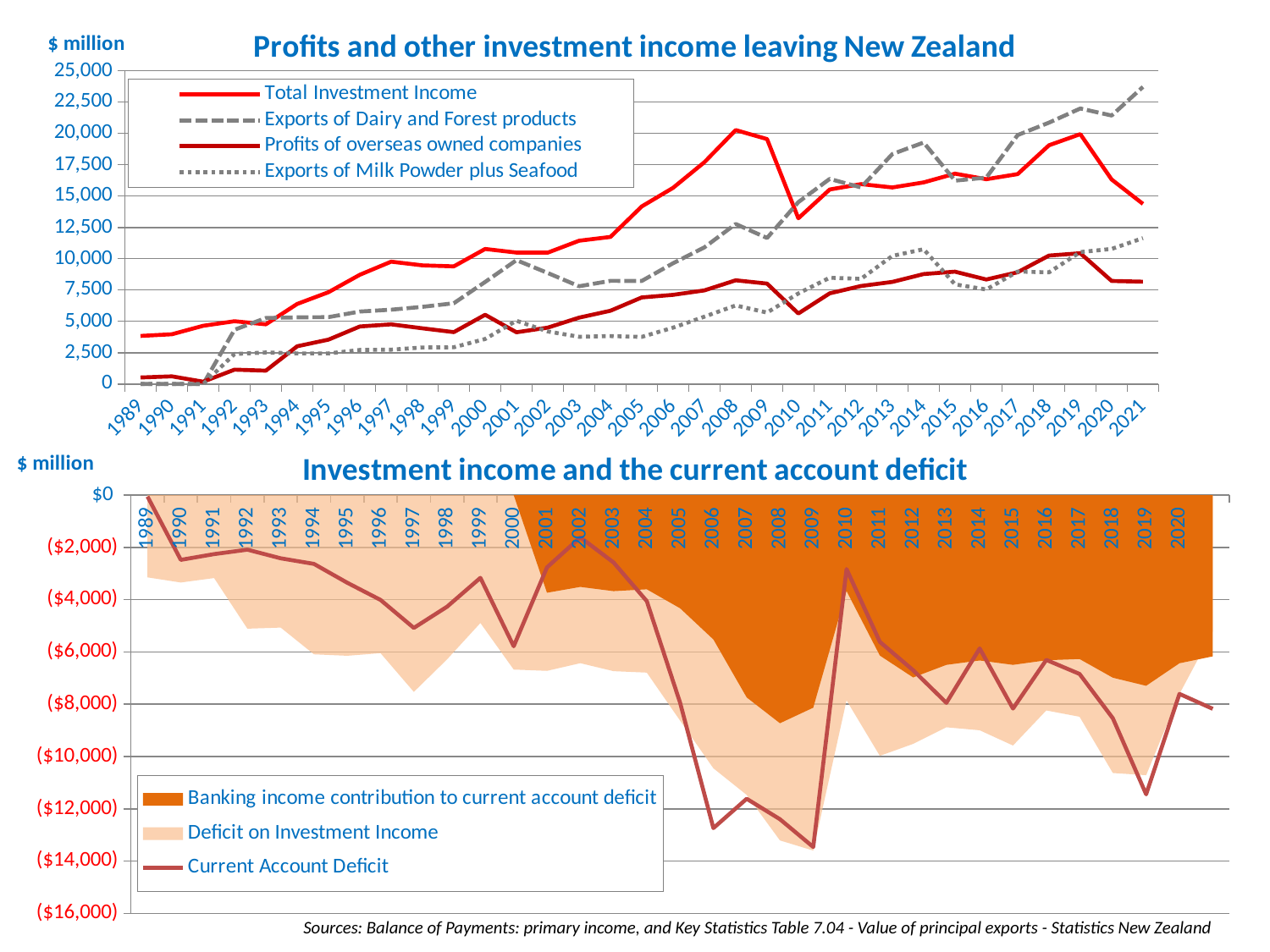
In the top chart, 'Profits and other investment income leaving New Zealand', is the value for Profits of overseas owned companies in 2021 greater or less than 10,000? less In the top chart, 'Profits and other investment income leaving New Zealand', how many years are shown on the x axis? 33 In the top chart, 'Profits and other investment income leaving New Zealand', is the value for Total Investment Income in 2010 greater or less than 15,000? less In the bottom chart, 'Investment income and the current account deficit', is the value for Current Account Deficit in 2009 greater or less than ($12,000)? less In the top chart, 'Profits and other investment income leaving New Zealand', which is larger in 2021: Total Investment Income or Exports of Dairy and Forest products? Exports of Dairy and Forest products In the bottom chart, 'Investment income and the current account deficit', in which year is the Current Account Deficit line at its lowest point? 2009 In the top chart, 'Profits and other investment income leaving New Zealand', does Total Investment Income rise or fall from 2019 to 2021? Fall How many series does the legend of the bottom chart, 'Investment income and the current account deficit', list? 3 What kind of chart is the top chart, 'Profits and other investment income leaving New Zealand'? Line chart In the top chart, 'Profits and other investment income leaving New Zealand', in which year is Exports of Dairy and Forest products highest? 2021 How many series does the legend of the top chart, 'Profits and other investment income leaving New Zealand', list? 4